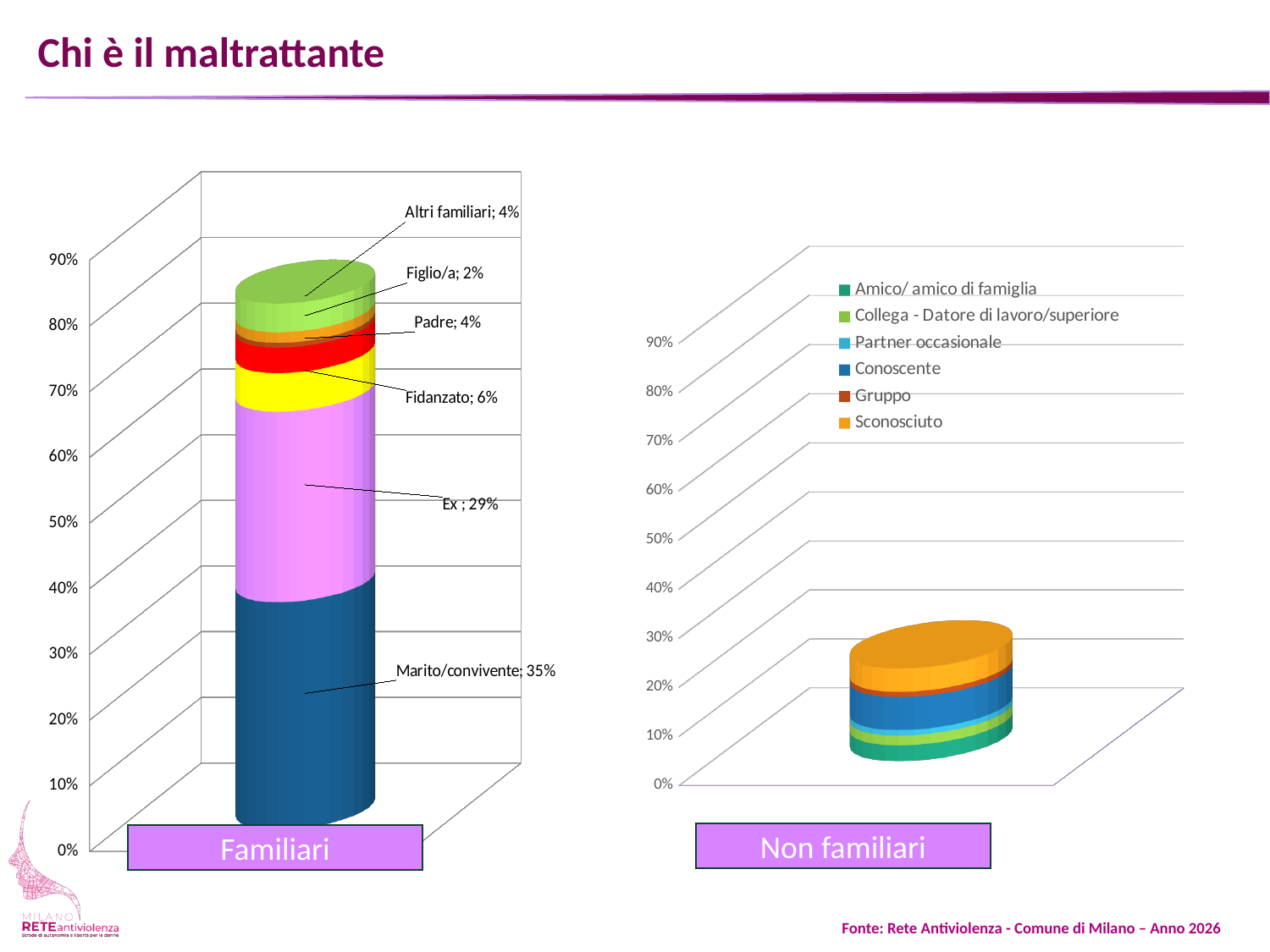
In the Familiari chart, what is the value for Marito/convivente? 35% In the Familiari chart, what is the value for Fidanzato? 6% In the Familiari chart, what is the difference between Marito/convivente and Ex? 6% What kind of chart is the Non familiari chart? Bar chart How many series does the legend of the Non familiari chart list? 6 In the Familiari chart, which category has the highest value? Marito/convivente In the Non familiari chart, which legend entry is shown in orange? Sconosciuto In the Familiari chart, which is larger, Fidanzato or Padre? Fidanzato In the Familiari chart, what is the value for Figlio/a? 2% In the Familiari chart, what is the value for Ex? 29%